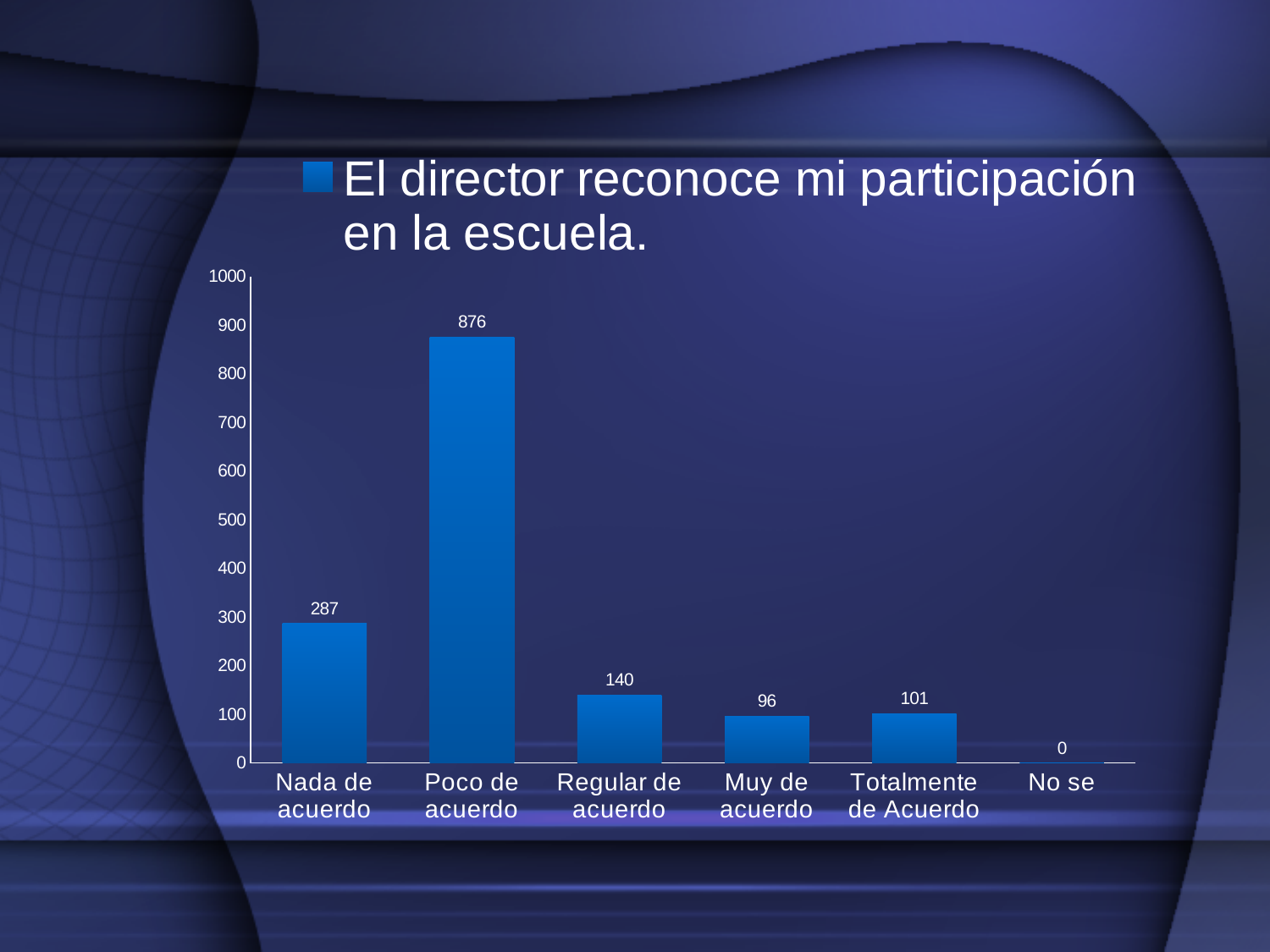
What is the value for "Nada de acuerdo"? 287 Which is larger, the value for "Totalmente de Acuerdo" or the value for "Muy de acuerdo"? Totalmente de Acuerdo What kind of chart is shown on the slide? Bar chart What is the difference between the values for "Poco de acuerdo" and "Nada de acuerdo"? 589 What is the difference between the values for "Regular de acuerdo" and "Totalmente de Acuerdo"? 39 What is the title of the chart? El director reconoce mi participación en la escuela. What is the value for "Poco de acuerdo"? 876 Which category has the highest value? Poco de acuerdo What is the value for "Muy de acuerdo"? 96 What is the value for "No se"? 0 Which category has the lowest value? No se How many categories are shown on the x axis? 6